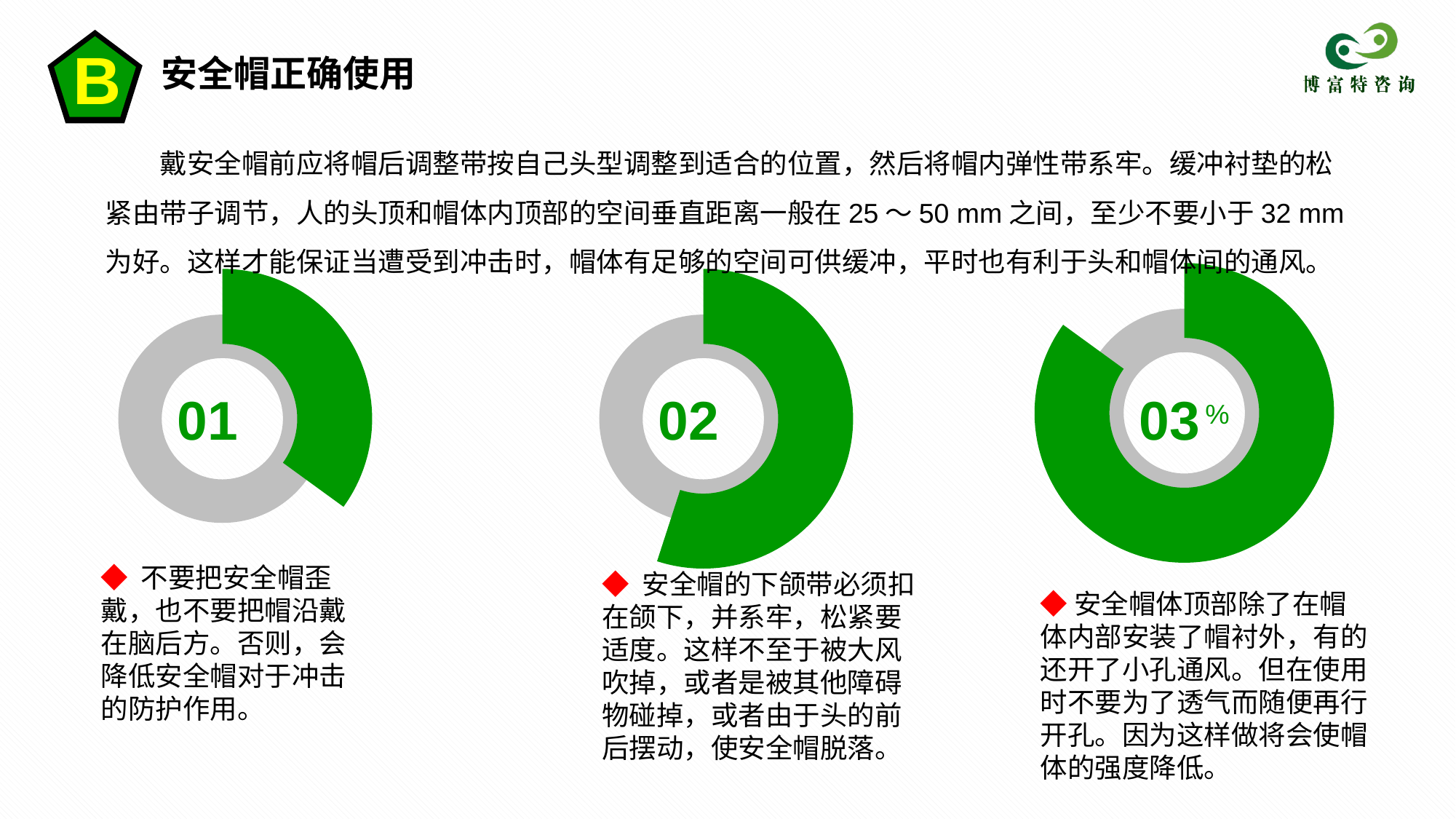
In the middle donut chart, is the green segment larger or smaller than the grey segment? Larger What label is printed in the centre of the middle donut chart? 02 Is the green segment larger in the chart labelled 01 or in the chart labelled 02? 02 How many segments does each donut chart have? 2 In the leftmost donut chart, is the green segment larger or smaller than the grey segment? Smaller How many donut charts are shown on the slide? 3 What kind of chart is used for the three graphics in the middle of the slide? Donut (pie) chart Which donut chart has the smallest green segment? The leftmost chart (01) Which donut chart has the largest green segment? The rightmost chart (03) What two colours are used for the segments of the donut charts? Green and grey